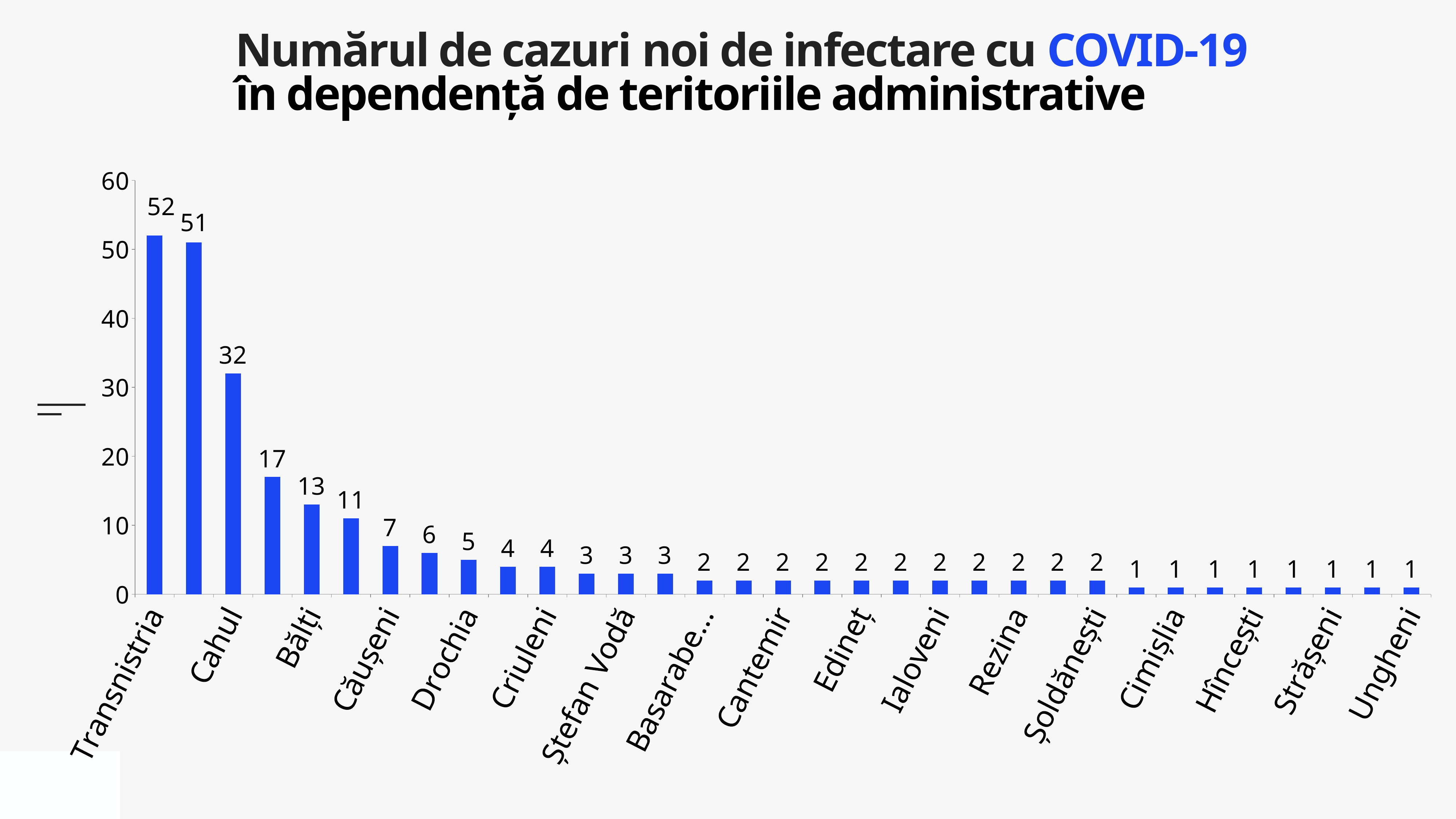
How many new cases are shown for Cahul? 32 What type of chart is shown on the slide? bar chart How many new cases are shown for Drochia? 5 Which has more new cases, Bălți or Căușeni? Bălți How many bars are plotted in the chart? 33 Do the values rise or fall from left to right along the x axis? fall What is the difference between the number of cases for Transnistria and Cahul? 20 How many new cases are shown for Ungheni? 1 Which territory has the highest number of new COVID-19 cases? Transnistria How many new cases are shown for Transnistria? 52 Is the value for Transnistria greater or less than 50? greater How many new cases are shown for Bălți? 13